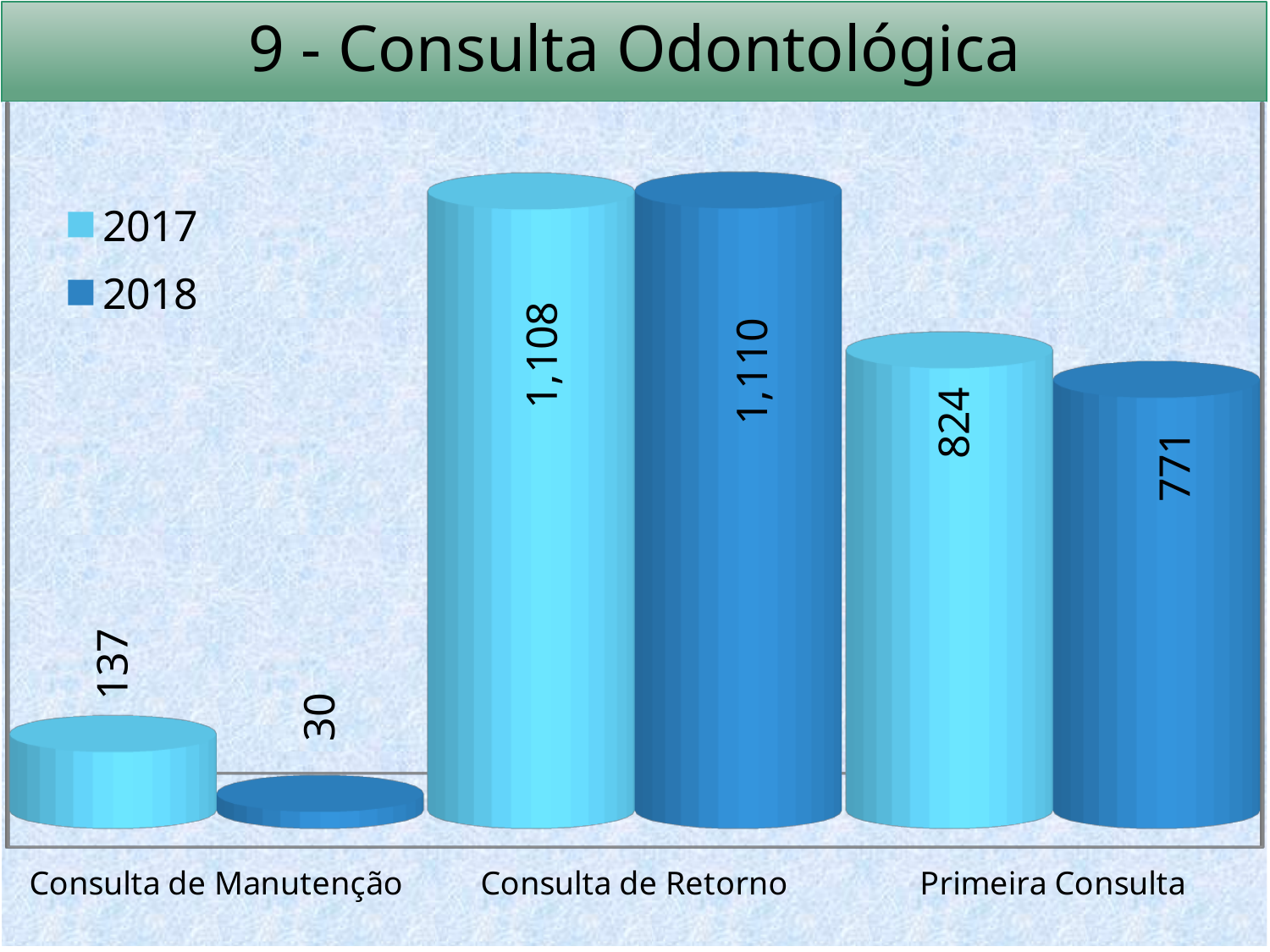
What is the value for Consulta de Manutenção in 2018? 30 What is the difference between the 2017 and 2018 values for Primeira Consulta? 53 What is the value for Consulta de Manutenção in 2017? 137 What is the difference between the 2017 and 2018 values for Consulta de Manutenção? 107 What is the value for Consulta de Retorno in 2018? 1,110 Which category has the highest value for 2017? Consulta de Retorno What is the value for Primeira Consulta in 2017? 824 Which category has the lowest value for 2018? Consulta de Manutenção How many categories are shown on the x axis? 3 How many series does the legend list? 2 Which is larger for Primeira Consulta, the 2017 value or the 2018 value? 2017 What kind of chart is shown on the slide? Bar chart